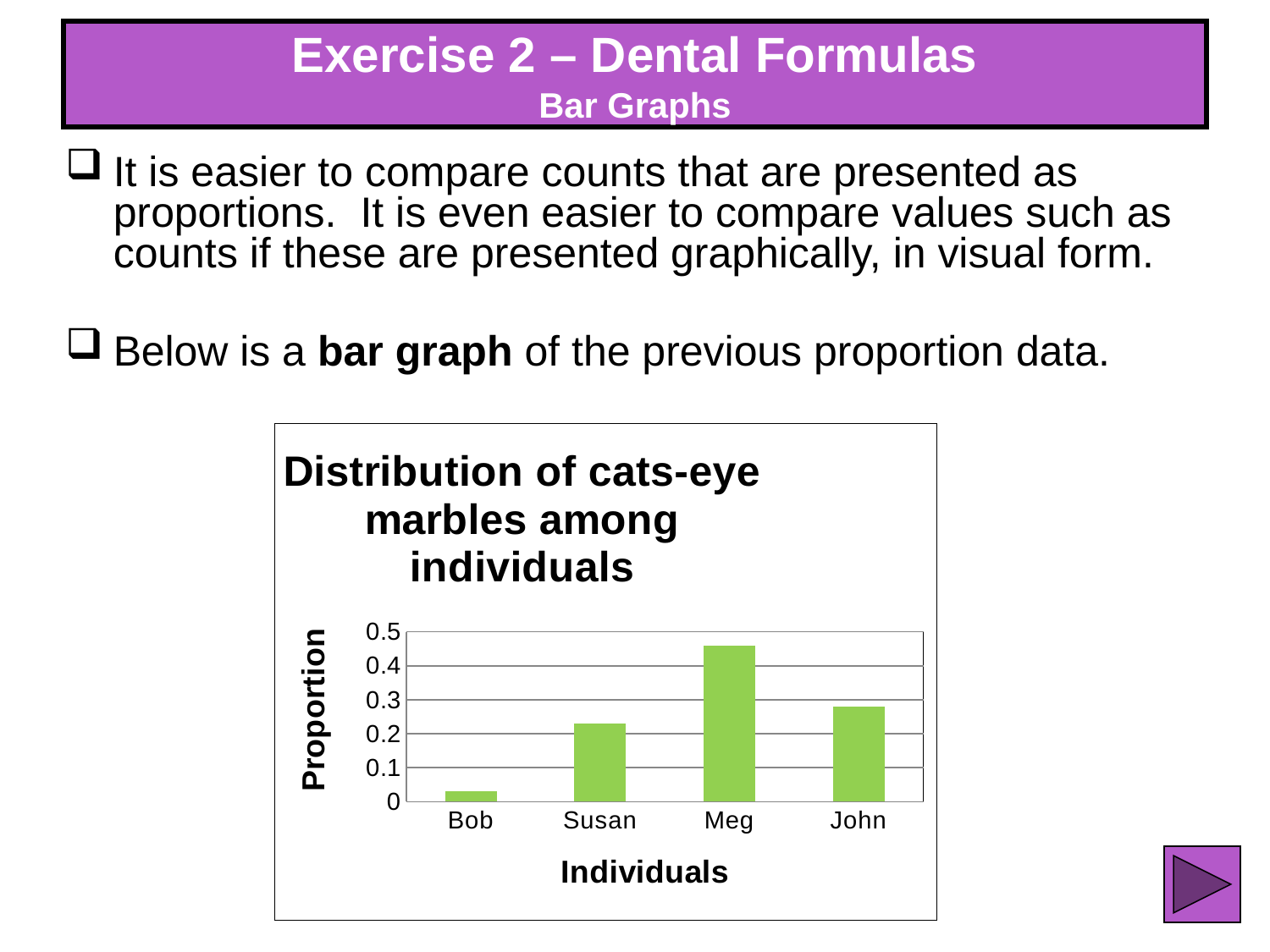
What kind of chart is shown on the slide? bar chart Is the proportion for Bob greater or less than 0.1? less Which individual has the highest proportion of cats-eye marbles? Meg Which individual has the lowest proportion of cats-eye marbles? Bob Is the proportion for Susan greater or less than 0.2? greater Is the proportion for Meg greater or less than 0.4? greater What is the label of the y axis of the chart? Proportion How many individuals are shown on the x axis of the chart? 4 Who has a larger proportion, Susan or John? John Who has a larger proportion, Meg or John? Meg What is the title of the chart? Distribution of cats-eye marbles among individuals